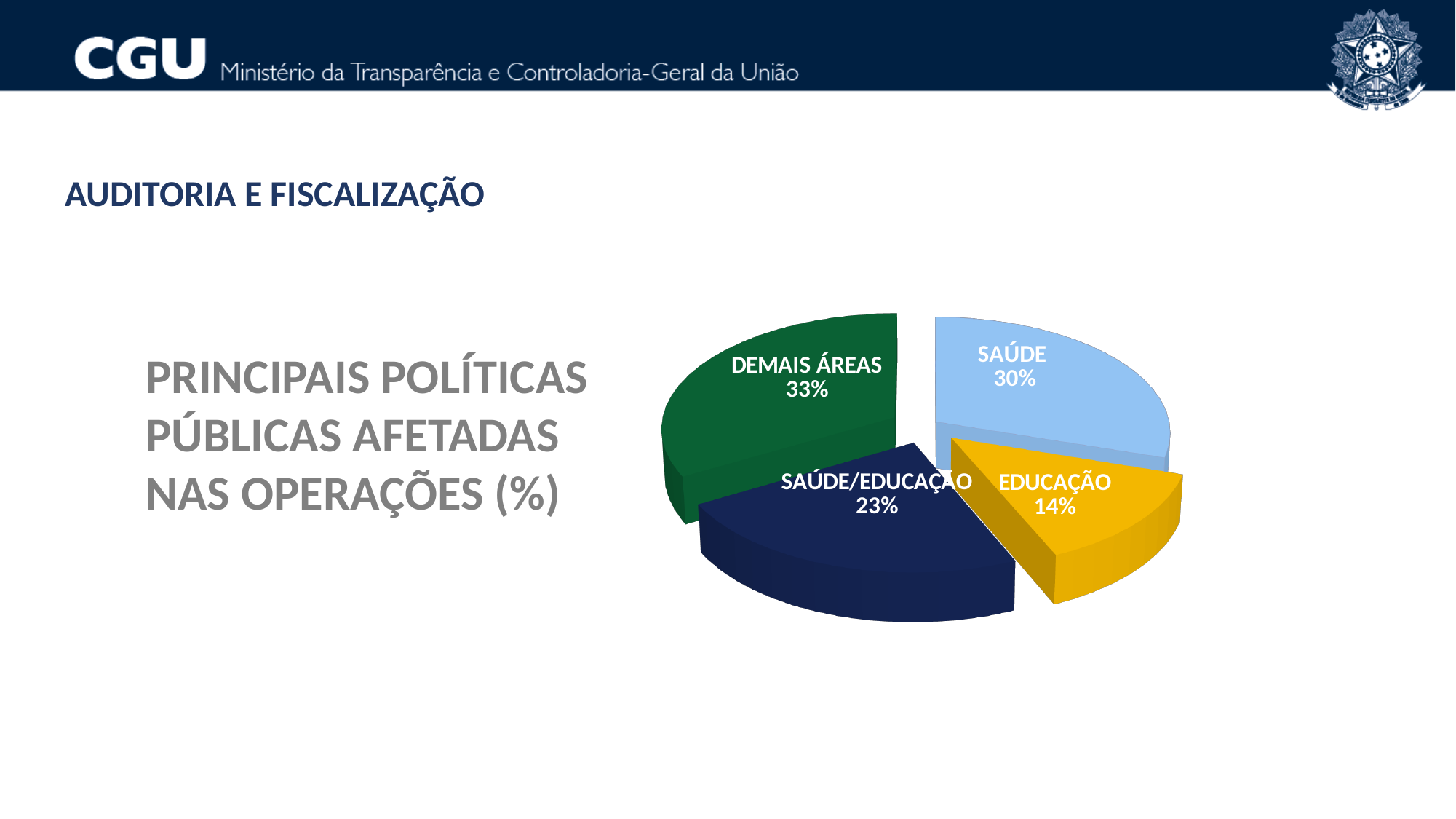
What percentage does the EDUCAÇÃO slice represent? 14% What is the difference in percentage points between DEMAIS ÁREAS and EDUCAÇÃO? 19 Which is larger, the share for SAÚDE or the share for SAÚDE/EDUCAÇÃO? SAÚDE What percentage does the SAÚDE/EDUCAÇÃO slice represent? 23% What percentage does the SAÚDE slice represent? 30% Which category has the largest share of the pie? DEMAIS ÁREAS How many slices does the pie chart have? 4 What percentage does the DEMAIS ÁREAS slice represent? 33% What is the combined share of SAÚDE and EDUCAÇÃO? 44% What colour is the SAÚDE/EDUCAÇÃO slice? Dark blue Which category has the smallest share of the pie? EDUCAÇÃO What kind of chart is shown on the slide? Pie chart